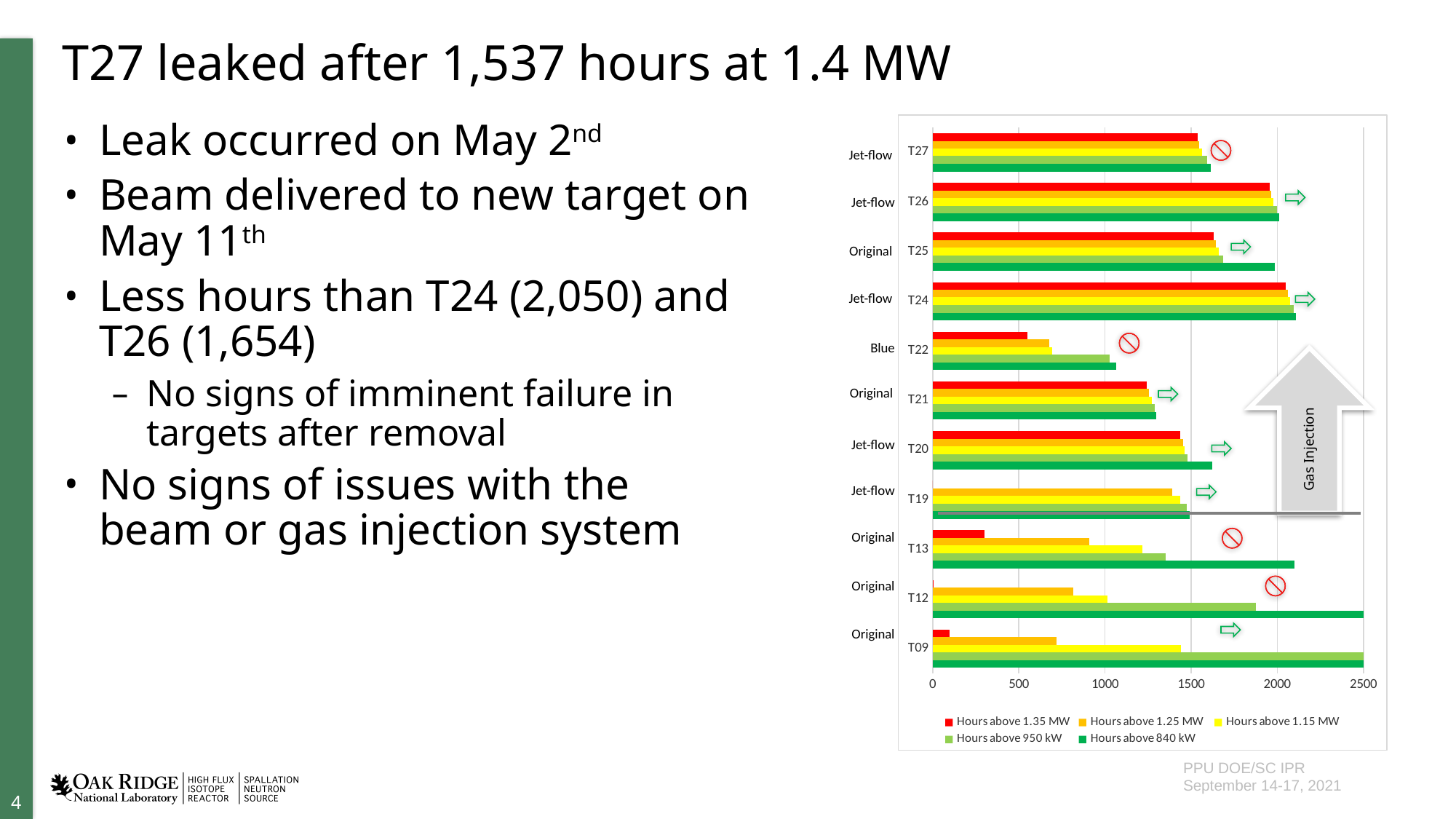
What kind of chart is shown on the slide? bar chart Is the value of Hours above 1.35 MW for T09 greater or less than 500? less Is the value of Hours above 1.35 MW for T26 greater or less than 1500? greater Is the value of Hours above 840 kW for T13 greater or less than 2000? greater What is the maximum value shown on the chart's horizontal axis? 2500 How many series does the chart legend list? 5 Which target has the lowest value for Hours above 1.35 MW? T19 Which has the larger value for Hours above 1.35 MW, T24 or T22? T24 How many targets (categories) are plotted on the chart? 11 Which series in the legend is shown in red? Hours above 1.35 MW